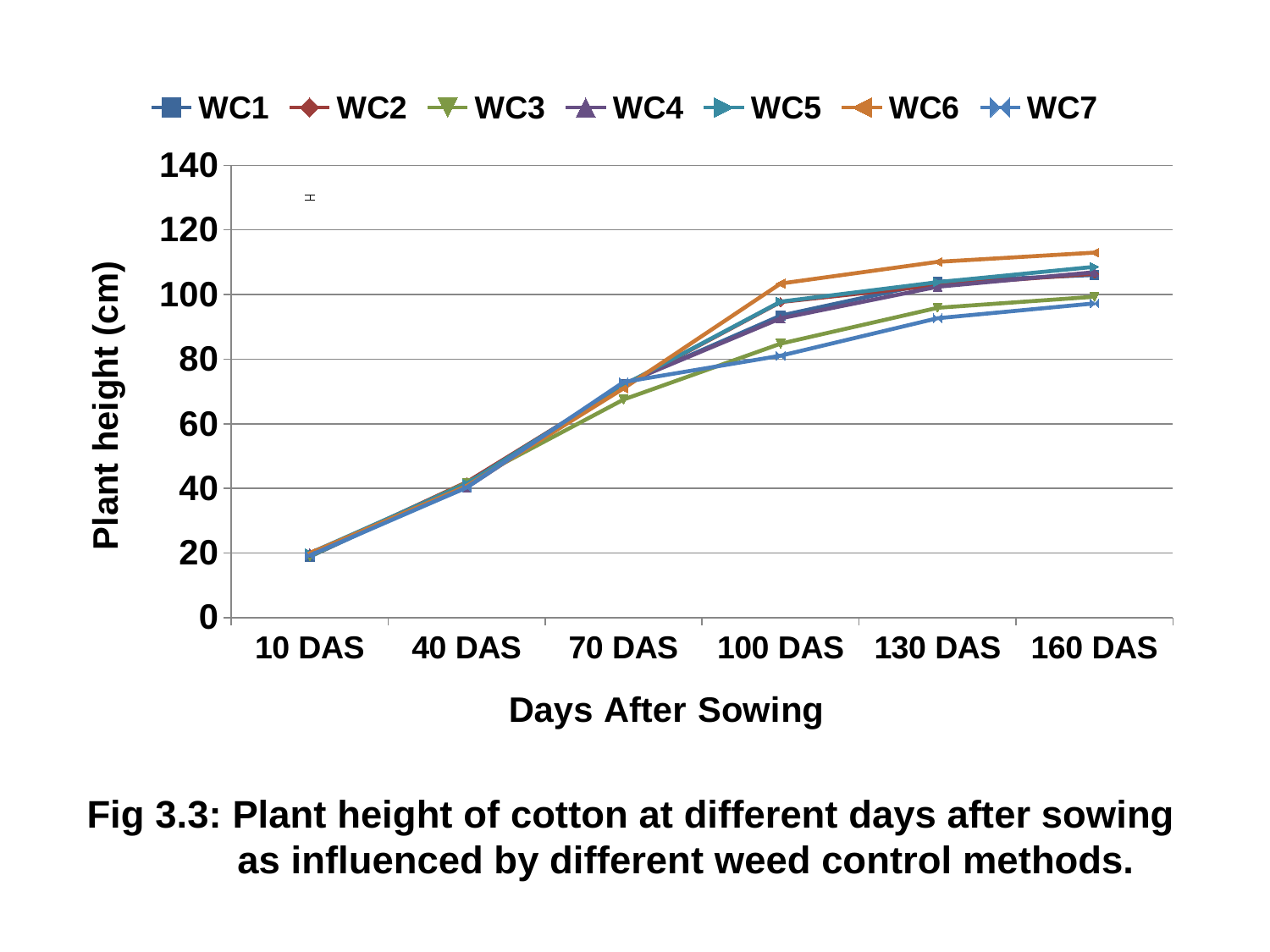
Is the plant height for WC3 at 100 DAS greater or less than 80? greater Is the plant height for WC7 at 100 DAS greater or less than 100? less Which series has the lowest plant height at 100 DAS? WC7 Do the plant height values rise or fall from 10 DAS to 160 DAS? rise Which series has the highest plant height at 100 DAS? WC6 Is the plant height for WC6 at 160 DAS greater or less than 100? greater At 160 DAS, which is larger: the plant height for WC6 or for WC7? WC6 What is the title of the y axis? Plant height (cm) What kind of chart is shown on the slide? line chart Which series has the highest plant height at 160 DAS? WC6 How many series does the legend list? 7 How many points are there along the x axis (Days After Sowing)? 6